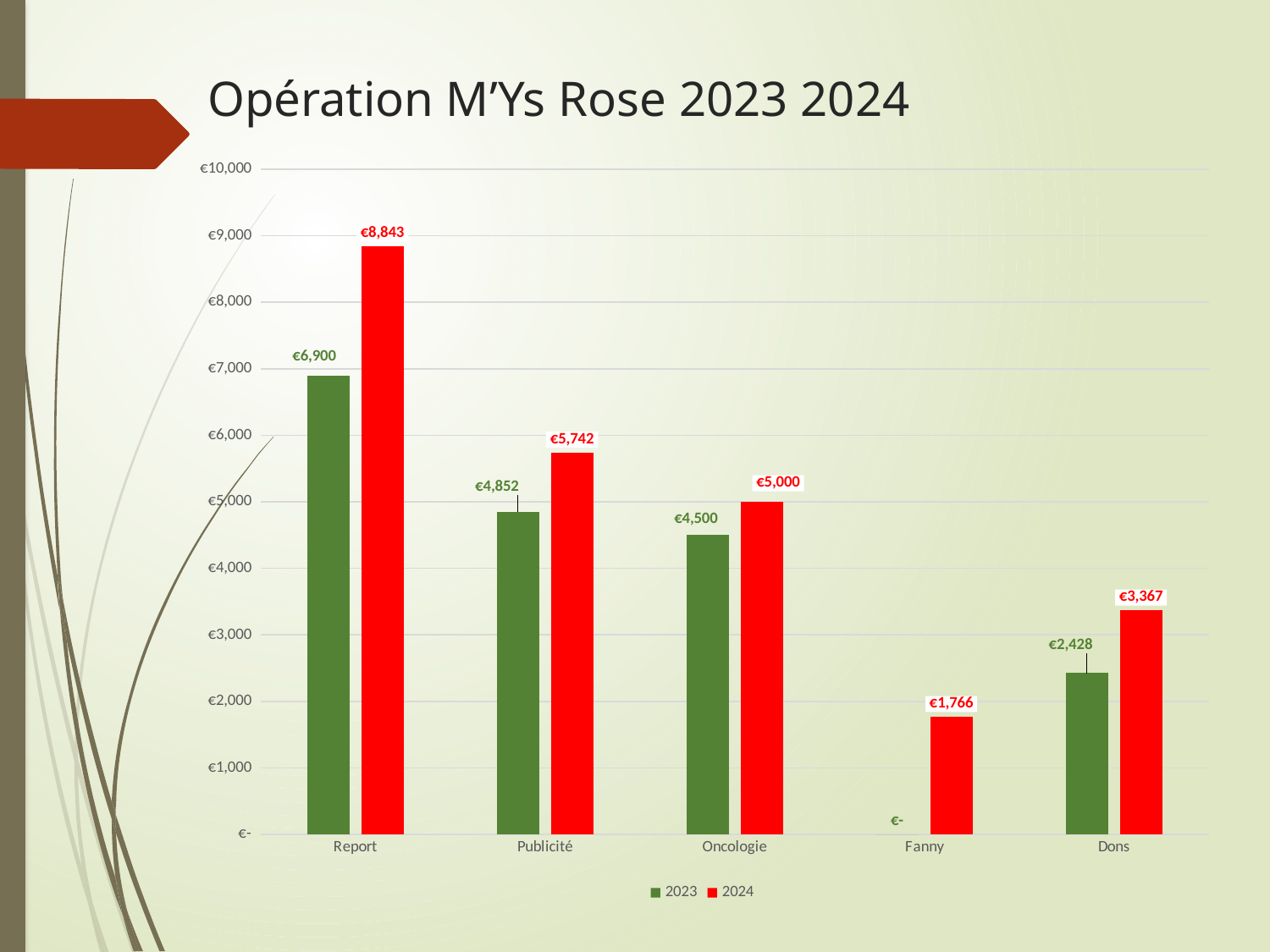
Which category has the highest value in the 2024 series? Report What is the value for Report in the 2024 series? €8,843 Is the 2024 value for Dons greater or less than €3,000? greater What is the value for Fanny in the 2024 series? €1,766 Which category has the lowest value in the 2023 series? Fanny How many categories are shown on the x axis? 5 How many series does the legend list? 2 What is the difference between the 2024 and 2023 values for Report? €1,943 Which is larger for Oncologie, the 2023 value or the 2024 value? 2024 What kind of chart is shown on the slide? Bar chart What is the value for Publicité in the 2023 series? €4,852 What is the value for Dons in the 2023 series? €2,428